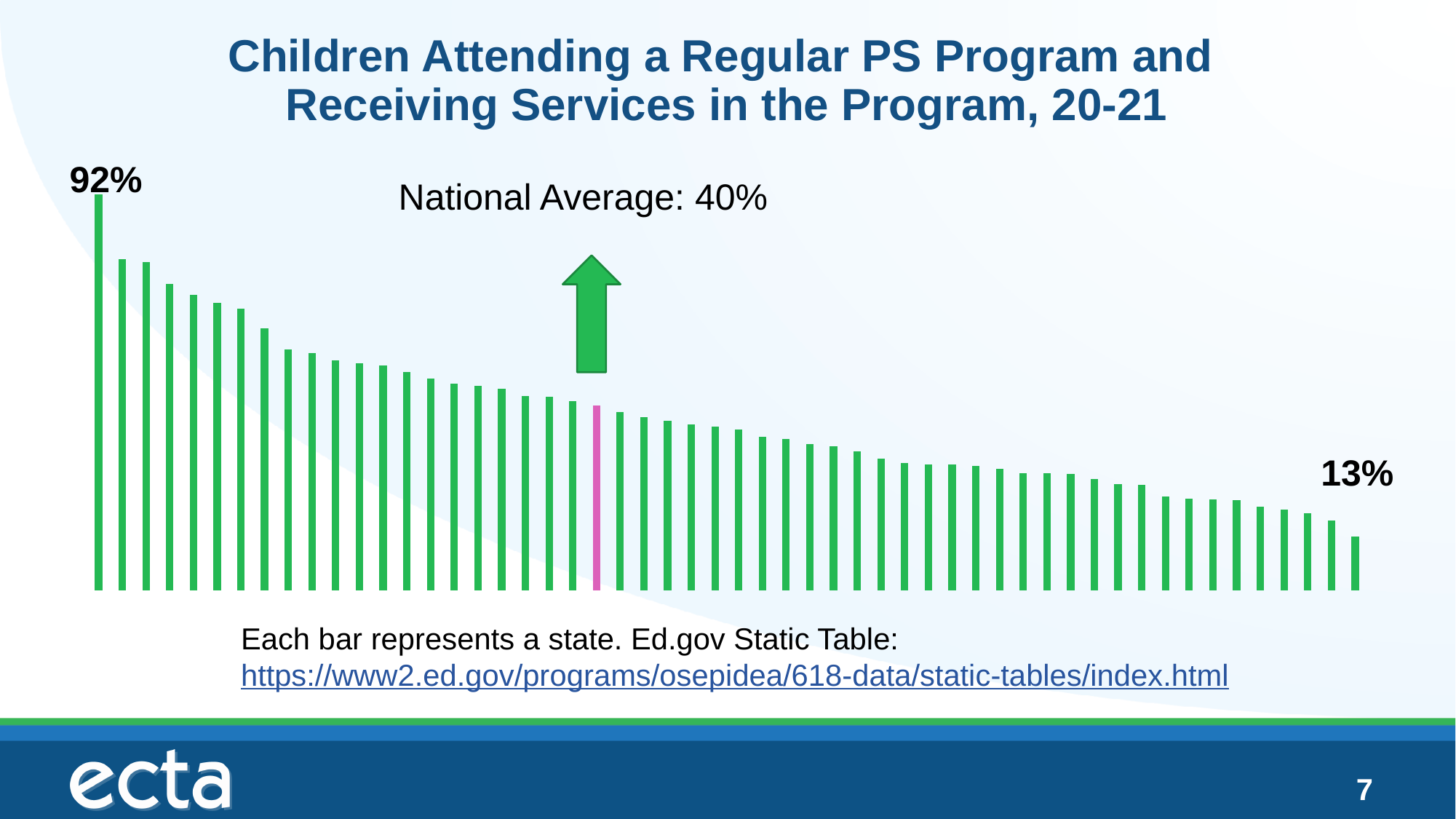
Is the highest value on the chart greater or less than the national average of 40%? greater What is the highest value shown on the chart? 92% Is the lowest value on the chart greater or less than the national average of 40%? less What does each bar in the chart represent? A state Do the bar values rise or fall from left to right across the chart? Fall What is the difference between the highest value (92%) and the lowest value (13%) on the chart? 79% What colour is the bar that marks the national average? Pink What is the lowest value shown on the chart? 13% What national average is stated on the chart? 40% Which is larger, the highest state value or the national average? The highest state value (92%) What kind of chart is shown on the slide? Bar chart